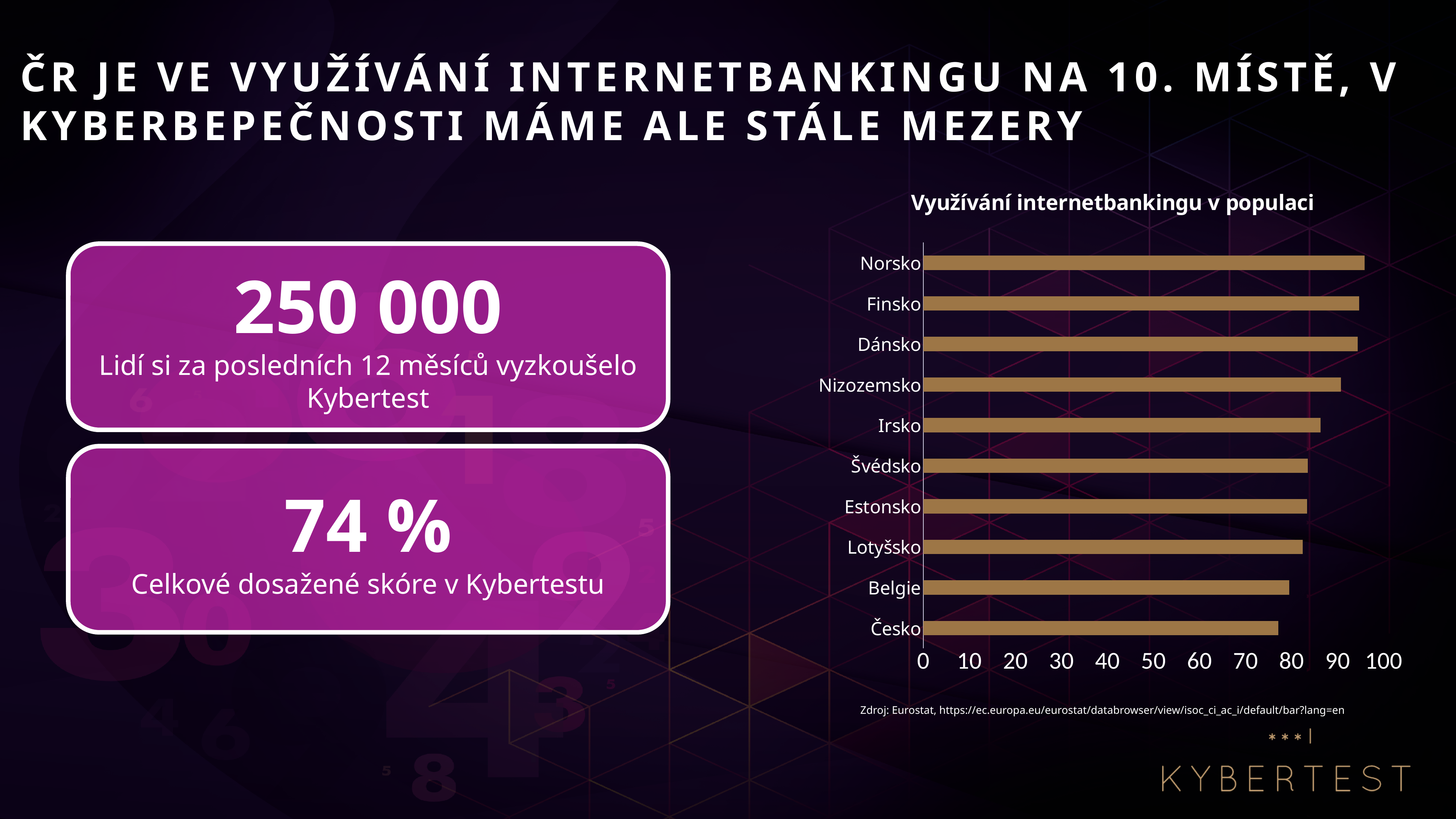
How many countries are shown in the chart? 10 Which country has the lowest value in the chart? Česko Is the value for Norsko greater or less than 90? greater What is the title of the chart? Využívání internetbankingu v populaci Is the value for Irsko greater or less than 90? less Is the value for Belgie greater or less than 90? less Which has a higher value, Norsko or Česko? Norsko What kind of chart is shown on the slide? bar chart Which country is listed at the top of the chart? Norsko Which has a higher value, Nizozemsko or Belgie? Nizozemsko